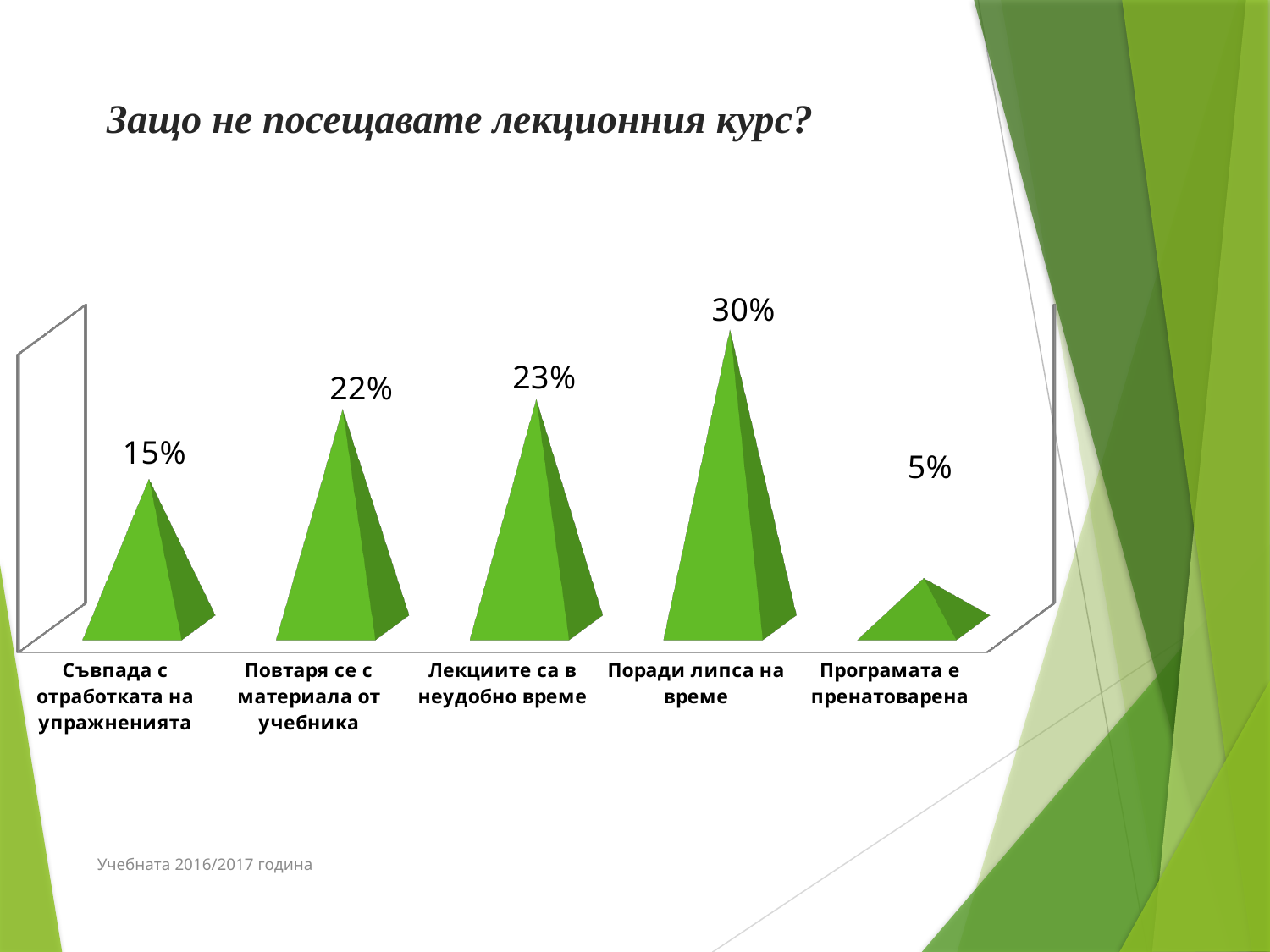
Which is larger: the value for "Повтаря се с материала от учебника" or for "Съвпада с отработката на упражненията"? Повтаря се с материала от учебника What is the difference between the values for "Лекциите са в неудобно време" and "Повтаря се с материала от учебника"? 1% Which category has the highest value? Поради липса на време How many categories are shown in the chart? 5 What is the value for "Съвпада с отработката на упражненията"? 15% What is the value for "Лекциите са в неудобно време"? 23% What kind of chart is shown on the slide? Bar chart What is the difference between the values for "Поради липса на време" and "Програмата е пренатоварена"? 25% What is the value for "Поради липса на време"? 30% What is the value for "Програмата е пренатоварена"? 5% What is the title of the slide above the chart? Защо не посещавате лекционния курс? Which category has the lowest value? Програмата е пренатоварена